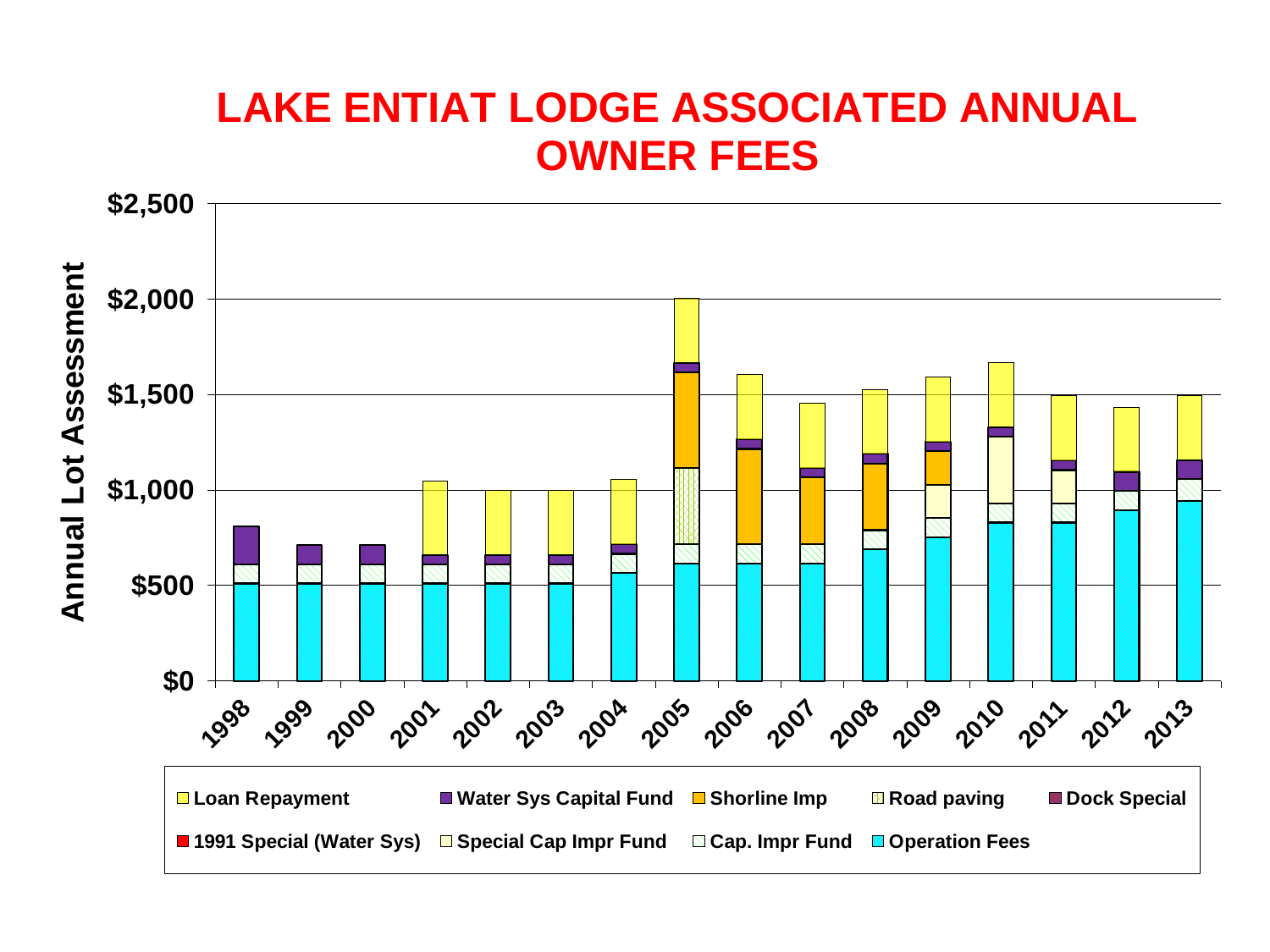
Is the total annual lot assessment for 2001 greater or less than $1,000? greater What is the label on the chart's vertical axis? Annual Lot Assessment How many years are shown along the x axis of the chart? 16 Which year has the larger total annual lot assessment, 2005 or 2006? 2005 Overall, do the total annual lot assessments rise or fall from 1998 to 2013? rise Which year has the larger total annual lot assessment, 2010 or 2011? 2010 Is the total annual lot assessment for 2010 greater or less than $1,500? greater How many series does the chart's legend list? 9 What kind of chart is shown on the slide? Stacked bar chart Which year has the highest total annual lot assessment? 2005 Is the total annual lot assessment for 2012 greater or less than $1,500? less